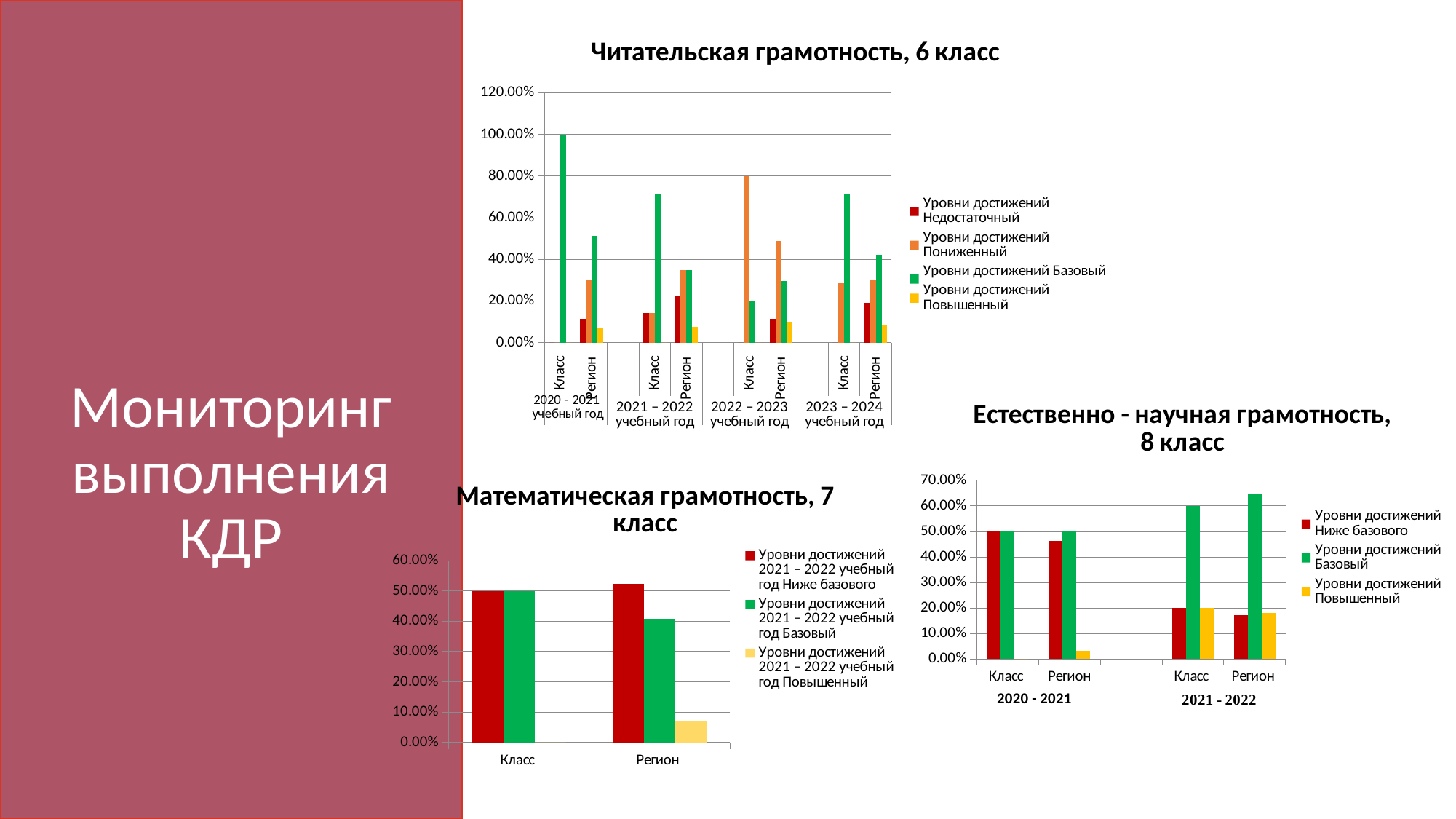
In 'Естественно - научная грамотность, 8 класс', is the value of 'Уровни достижений Базовый' for Регион in 2021 - 2022 greater or less than 60.00%? greater In 'Читательская грамотность, 6 класс', is the value of 'Уровни достижений Базовый' for Класс in 2020 - 2021 учебный год greater or less than 80.00%? greater How many series does the legend of 'Математическая грамотность, 7 класс' list? 3 In 'Математическая грамотность, 7 класс', is the value of 'Уровни достижений 2021 – 2022 учебный год Повышенный' for Регион greater or less than 10.00%? less In 'Читательская грамотность, 6 класс', which is larger for Регион in 2023 – 2024 учебный год: 'Уровни достижений Базовый' or 'Уровни достижений Пониженный'? Уровни достижений Базовый What kind of chart is 'Читательская грамотность, 6 класс'? bar chart How many series does the legend of 'Читательская грамотность, 6 класс' list? 4 In 'Читательская грамотность, 6 класс', which series has the tallest bar for Класс in 2022 – 2023 учебный год? Уровни достижений Пониженный How many charts are on the slide? 3 In 'Естественно - научная грамотность, 8 класс', which series has the tallest bar for Класс in 2021 - 2022? Уровни достижений Базовый In 'Математическая грамотность, 7 класс', which is larger for Регион: 'Уровни достижений 2021 – 2022 учебный год Ниже базового' or 'Уровни достижений 2021 – 2022 учебный год Базовый'? Уровни достижений 2021 – 2022 учебный год Ниже базового